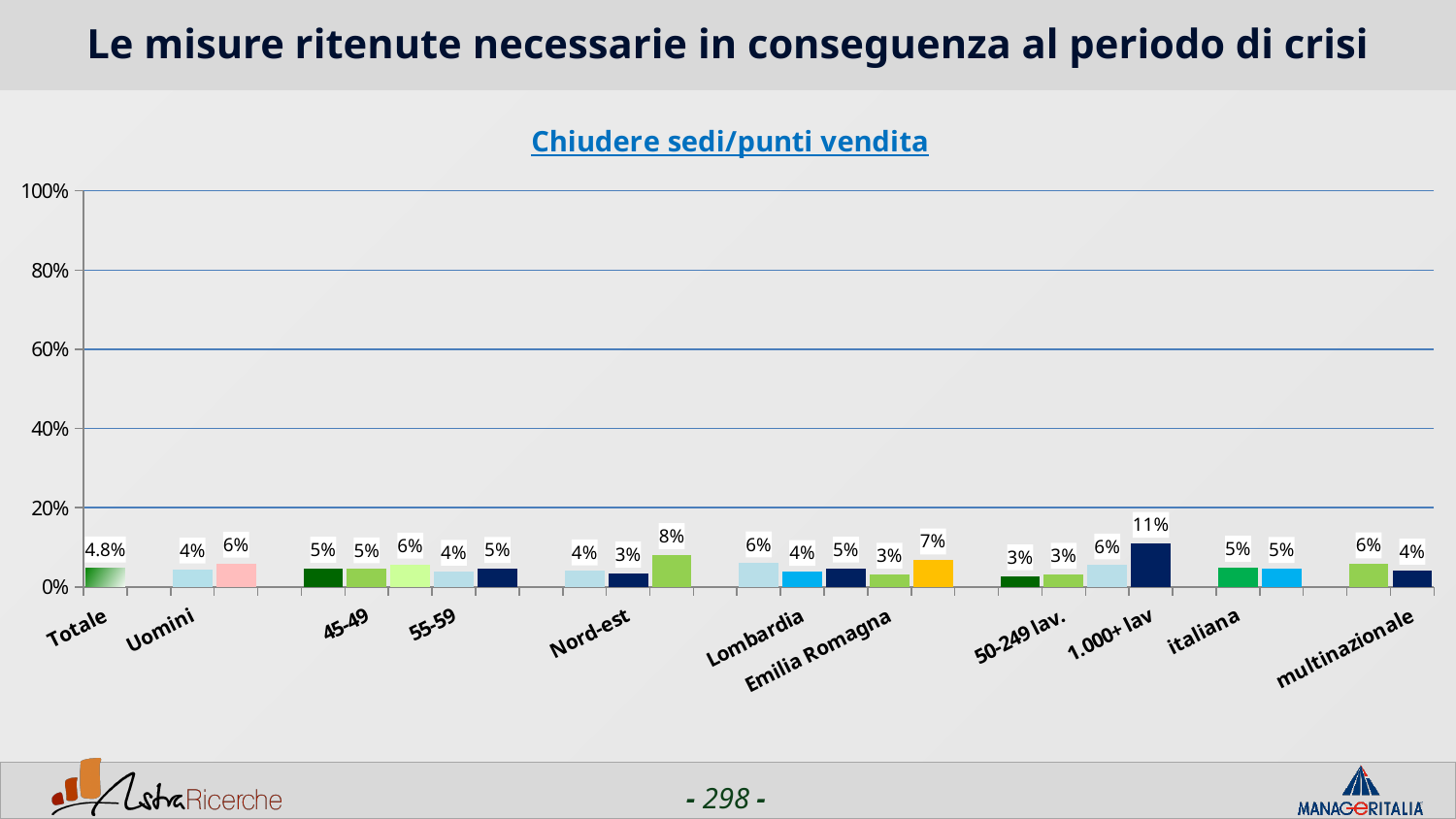
What is the value for italiana? 5% Which is larger, the value for Uomini or the value for 1.000+ lav? 1.000+ lav What is the difference between the values for 1.000+ lav and 50-249 lav.? 8 percentage points What is the value for Totale? 4.8% What is the value for Uomini? 4% What is the value for Emilia Romagna? 3% What is the value for 1.000+ lav? 11% Is the value for Totale greater or less than 20%? less What is the title of the chart? Chiudere sedi/punti vendita Which category has the highest value? 1.000+ lav What kind of chart is shown on the slide? Bar chart What is the value for Nord-est? 3%